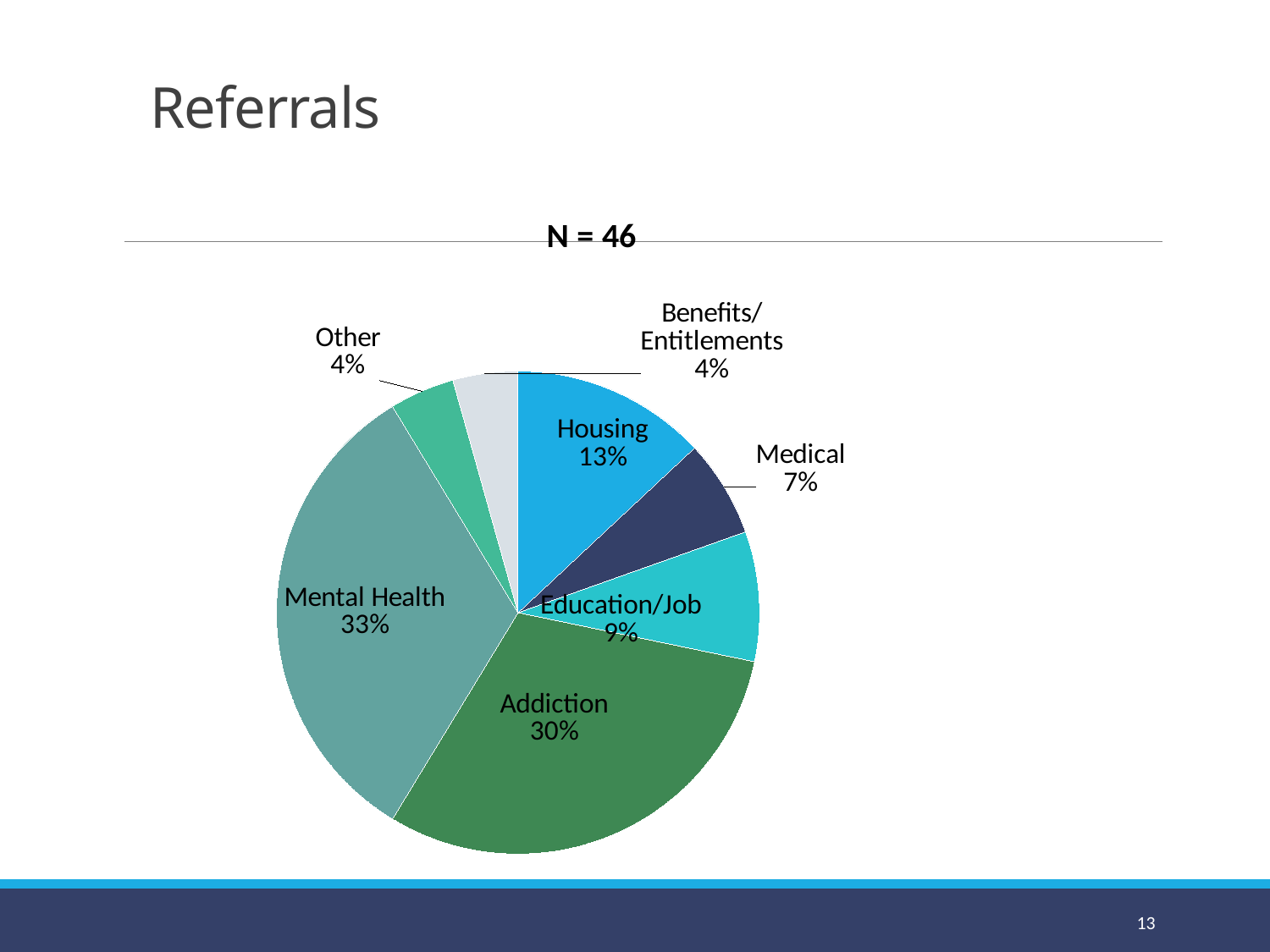
What share of referrals is Medical? 7% What is the difference in percentage points between Mental Health and Addiction? 3 Which referral category has the largest share of the pie? Mental Health What share of referrals is Addiction? 30% Which is larger, the Housing share or the Medical share? Housing How many slices does the pie chart have? 7 What share of referrals is Housing? 13% What is the title shown above the pie chart? N = 46 What kind of chart is shown on the slide? pie chart What is the difference in percentage points between Housing and Education/Job? 4